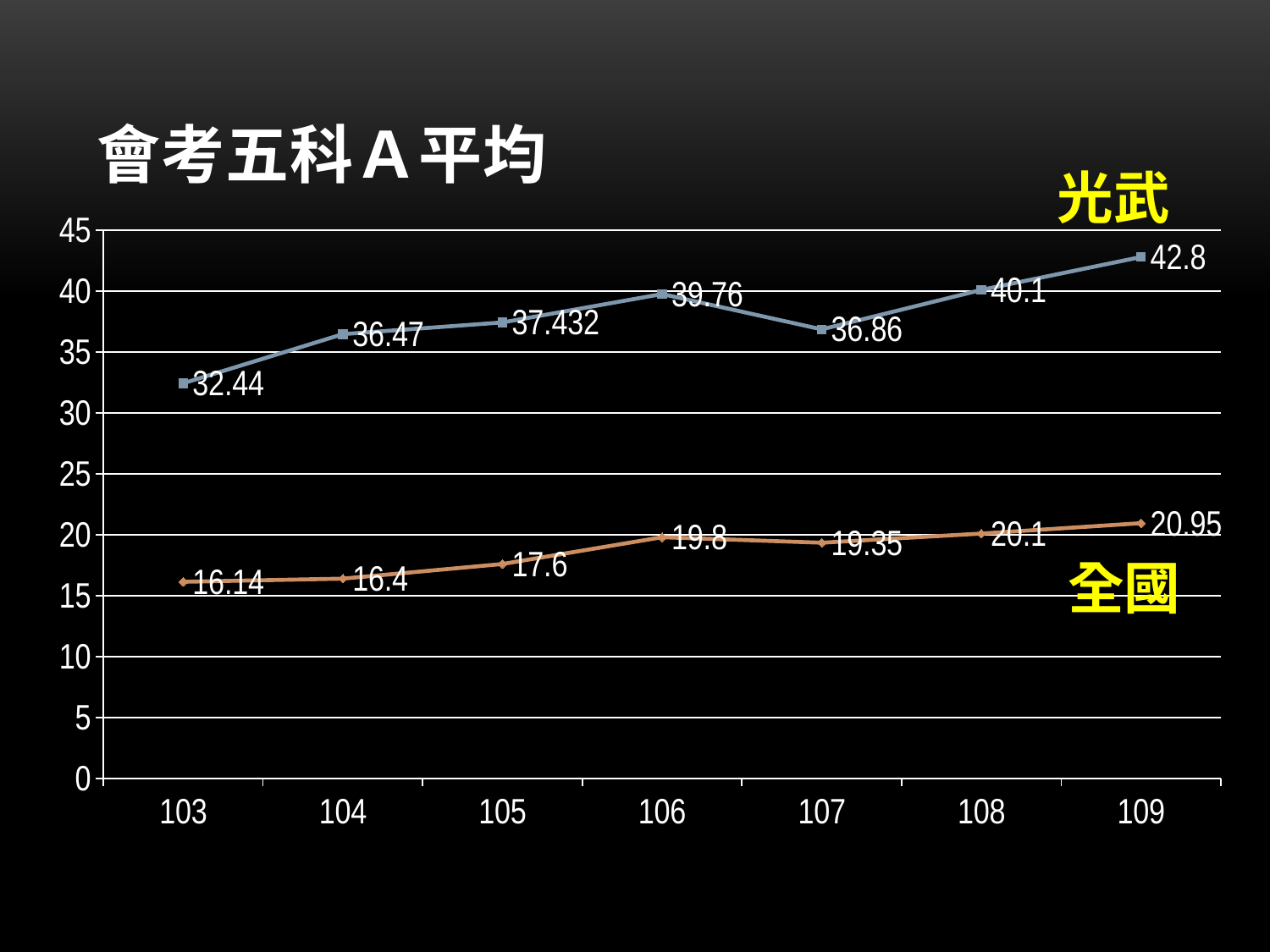
In which year is the 全國 value lowest? 103 What is the title of the chart? 會考五科A平均 What is the value for 全國 in 103? 16.14 What is the difference between the 光武 and 全國 values in 109? 21.85 What is the value for 光武 in 107? 36.86 Which is larger, the 光武 value in 106 or the 光武 value in 107? 106 What is the value for 全國 in 105? 17.6 How many years are shown on the x axis? 7 Is the value for 光武 in 103 greater or less than 30? greater What is the value for 光武 in 109? 42.8 What kind of chart is shown on the slide? line chart In which year is the 光武 value highest? 109